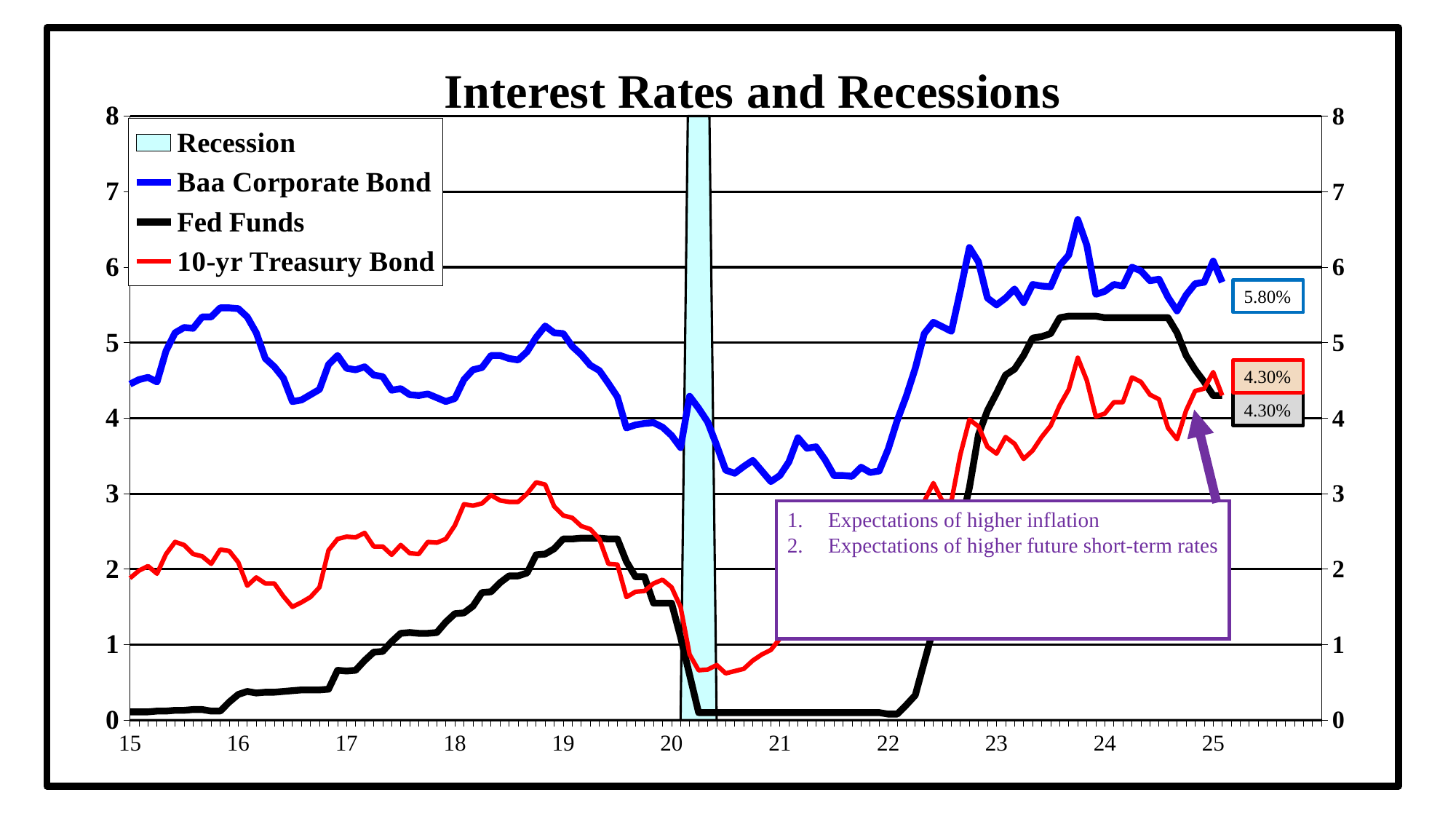
What is the title of the chart? Interest Rates and Recessions Is the Baa Corporate Bond value at 16 on the x axis greater or less than 5? greater What is the latest labelled value for the 10-yr Treasury Bond series? 4.30% What is the difference between the latest labelled Baa Corporate Bond value and the latest labelled 10-yr Treasury Bond value? 1.50% What kind of chart is shown on the slide? line chart Is the Fed Funds value at 21 on the x axis greater or less than 1? less What is the latest labelled value for the Baa Corporate Bond series? 5.80% Which series reaches the highest value anywhere on the chart? Baa Corporate Bond Does the Fed Funds series rise or fall between 22 and 23 on the x axis? rise How many entries does the chart's legend list? 4 At the end of the chart, which is larger: the Baa Corporate Bond rate or the Fed Funds rate? Baa Corporate Bond What is the latest labelled value for the Fed Funds series? 4.30%